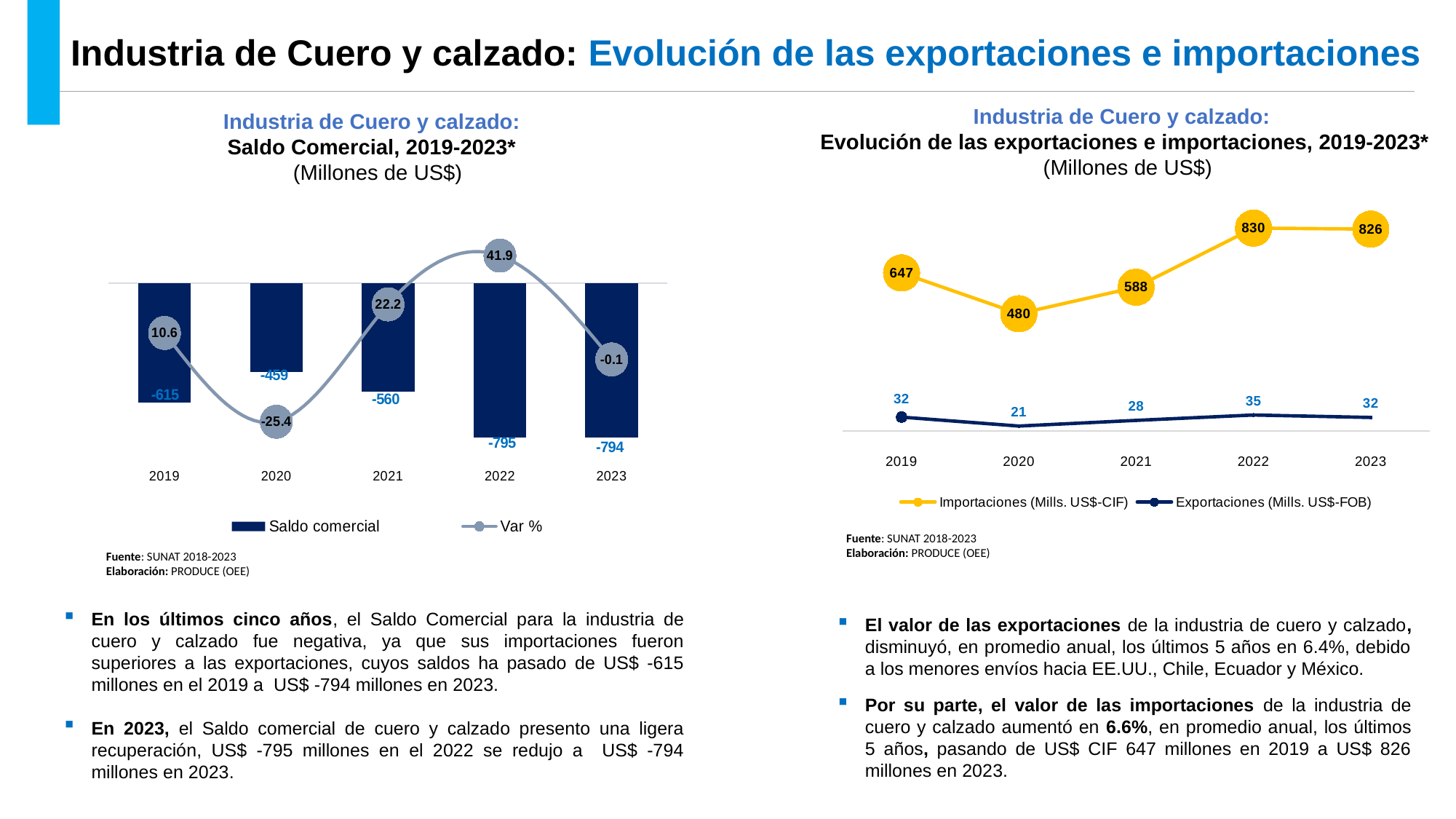
In the right chart (Evolución de las exportaciones e importaciones, 2019-2023*), what is the Exportaciones value for 2020? 21 In the right chart (Evolución de las exportaciones e importaciones, 2019-2023*), which year has the highest Importaciones value? 2022 In the left chart (Saldo Comercial, 2019-2023*), which year has the lowest Saldo comercial value? 2022 In the left chart (Saldo Comercial, 2019-2023*), how many series does the legend list? 2 In the left chart (Saldo Comercial, 2019-2023*), what is the Saldo comercial value for 2021? -560 In the right chart (Evolución de las exportaciones e importaciones, 2019-2023*), how many years are plotted on the x axis? 5 In the left chart (Saldo Comercial, 2019-2023*), what is the difference between the Saldo comercial values for 2019 and 2020? 156 In the right chart (Evolución de las exportaciones e importaciones, 2019-2023*), what is the difference between Importaciones and Exportaciones in 2023? 794 In the right chart (Evolución de las exportaciones e importaciones, 2019-2023*), what is the Importaciones value for 2021? 588 In the left chart (Saldo Comercial, 2019-2023*), which year has the lowest Var % value? 2020 In the left chart (Saldo Comercial, 2019-2023*), what is the Var % value for 2022? 41.9 In the right chart (Evolución de las exportaciones e importaciones, 2019-2023*), what type of chart is used? Line chart